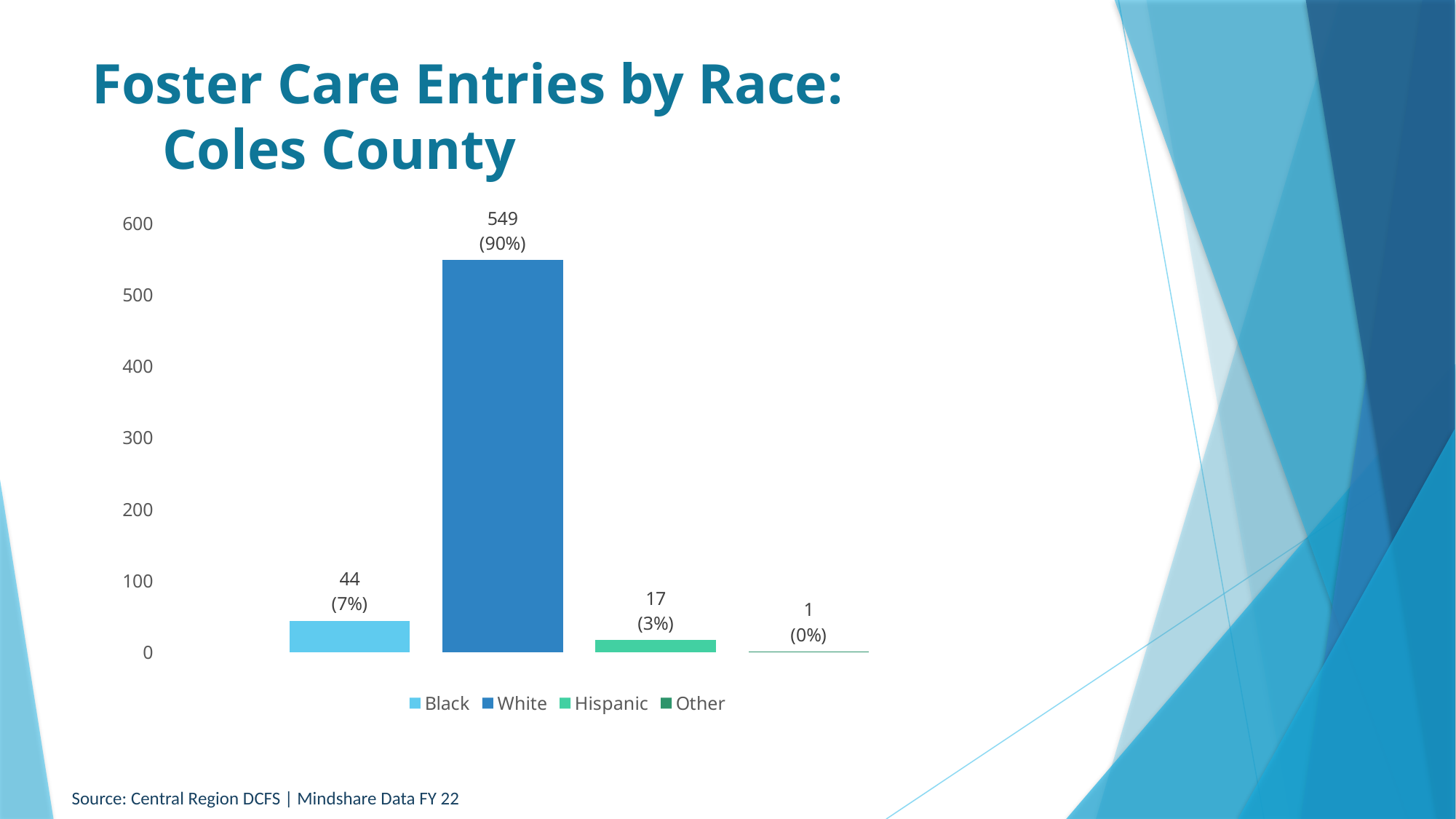
How many foster care entries are shown for Black? 44 Which has more foster care entries, Black or Hispanic? Black What is the source cited at the bottom of the slide? Central Region DCFS | Mindshare Data FY 22 What kind of chart is shown on the slide? Bar chart What is the difference between the number of entries for White and Black? 505 What percentage is shown for Hispanic? 3% How many foster care entries are shown for Other? 1 Is the value for White greater or less than 500? greater How many foster care entries are shown for White? 549 How many race categories are shown in the chart? 4 Which race category has the highest number of foster care entries? White Which race category has the lowest number of foster care entries? Other